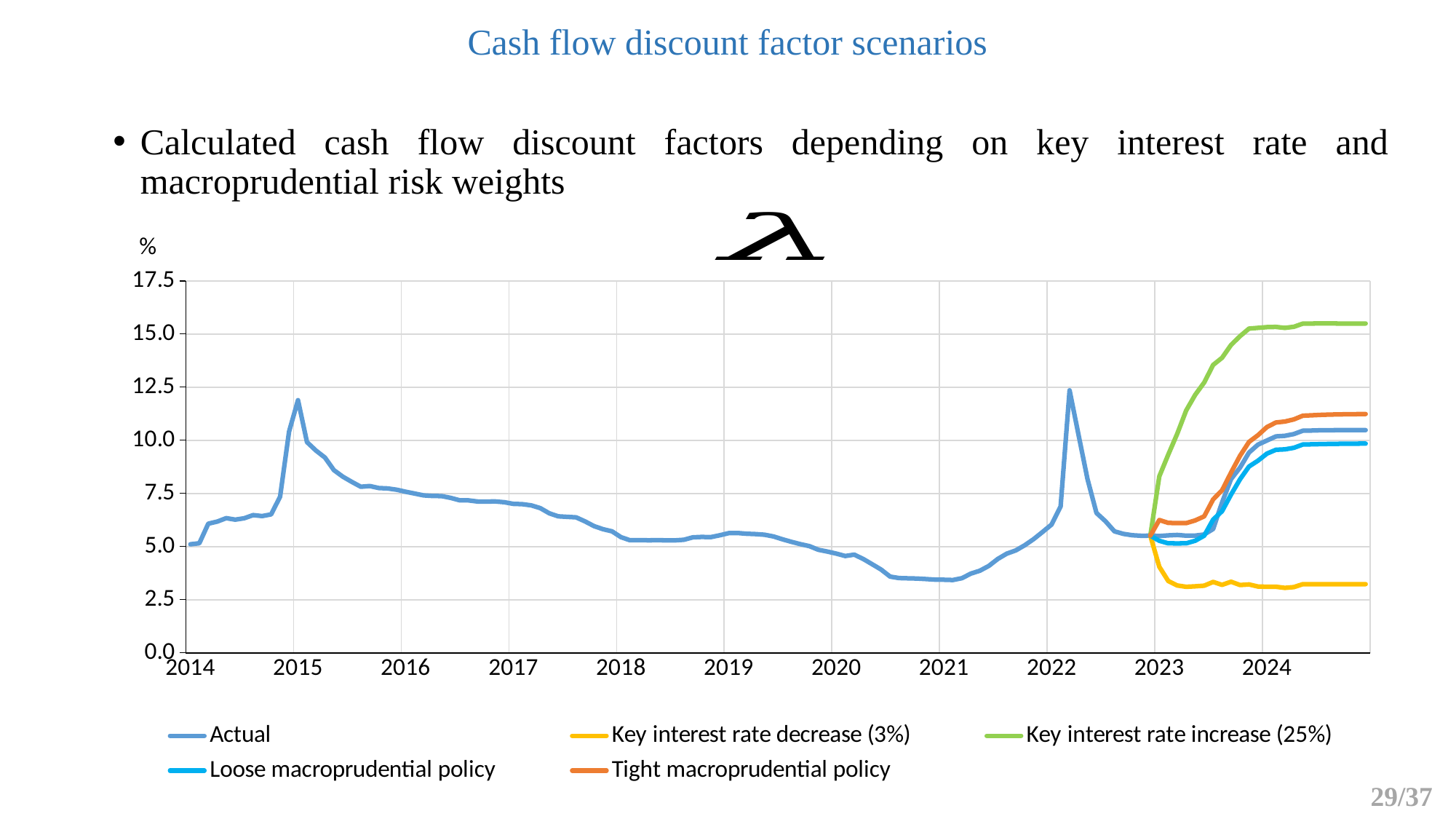
Which series ends at the highest value at the right edge of the chart (end of 2024)? Key interest rate increase (25%) At the end of 2024, which series is higher: Tight macroprudential policy or Loose macroprudential policy? Tight macroprudential policy What kind of chart is shown on the slide? line chart What is the unit label shown above the vertical axis? % Is the value of the Key interest rate decrease (3%) series at the end of 2024 greater or less than 5.0? less Which series ends at the lowest value at the right edge of the chart (end of 2024)? Key interest rate decrease (3%) Is the value of the Tight macroprudential policy series at the end of 2024 greater or less than 10.0? greater Does the Key interest rate increase (25%) series rise or fall from 2023 to 2024? rise How many series does the legend list? 5 Is the value of the Key interest rate increase (25%) series at the end of 2024 greater or less than 15.0? greater What colour is the line for the Key interest rate decrease (3%) series? yellow